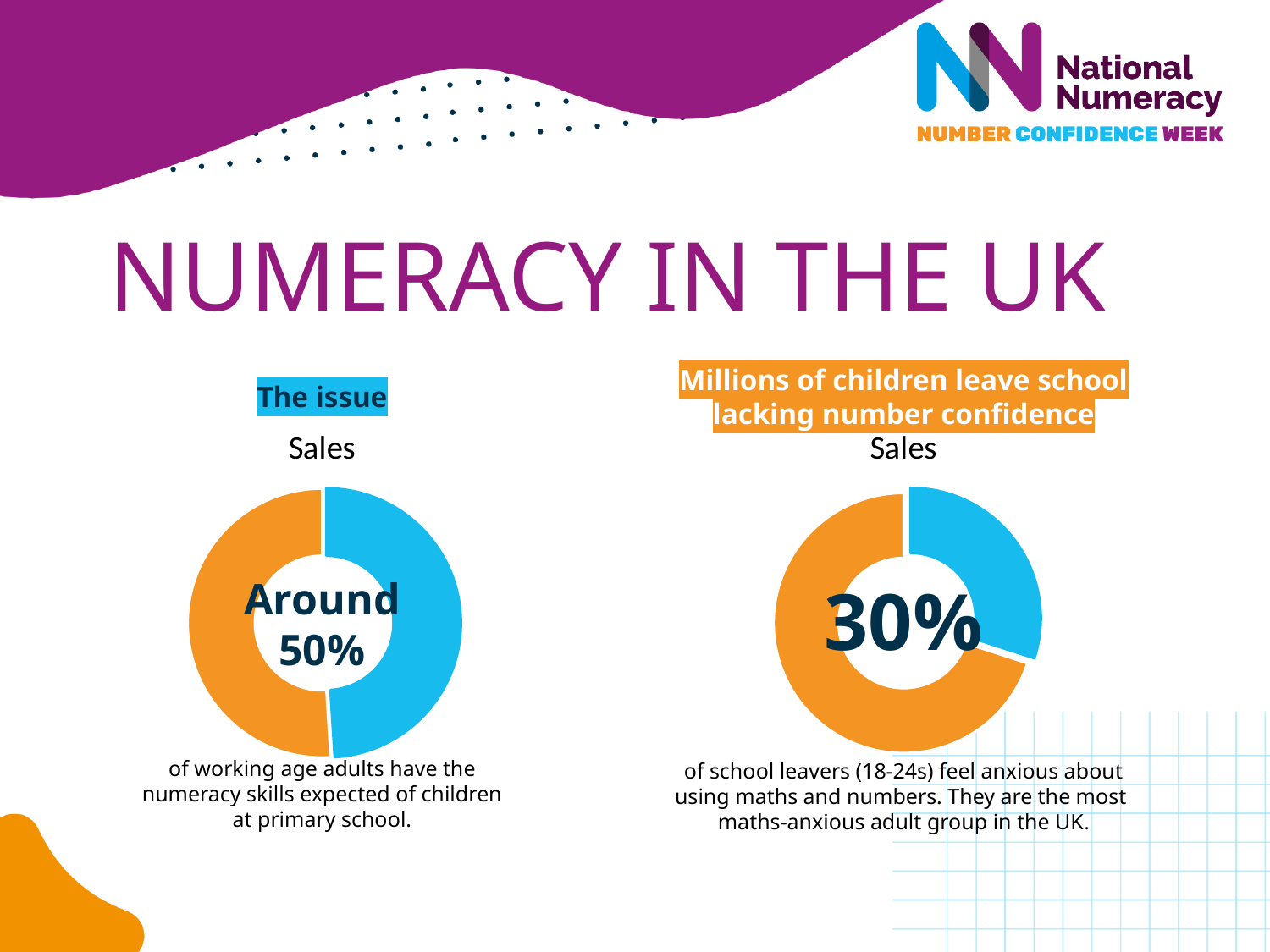
What is the title shown above the left doughnut chart? Sales How many slices does the left doughnut chart have? 2 What is the title shown above the right doughnut chart? Sales In the right doughnut chart, is the orange slice's share greater or less than 50%? greater What text is printed in the centre of the left doughnut chart? Around 50% What kind of chart is the right chart on the slide? Doughnut chart In the right doughnut chart, is the blue slice's share greater or less than 50%? less How many slices does the right doughnut chart have? 2 In the right doughnut chart, which slice is larger, the blue one or the orange one? Orange What percentage is printed in the centre of the right doughnut chart? 30% What kind of chart is the left chart on the slide? Doughnut chart